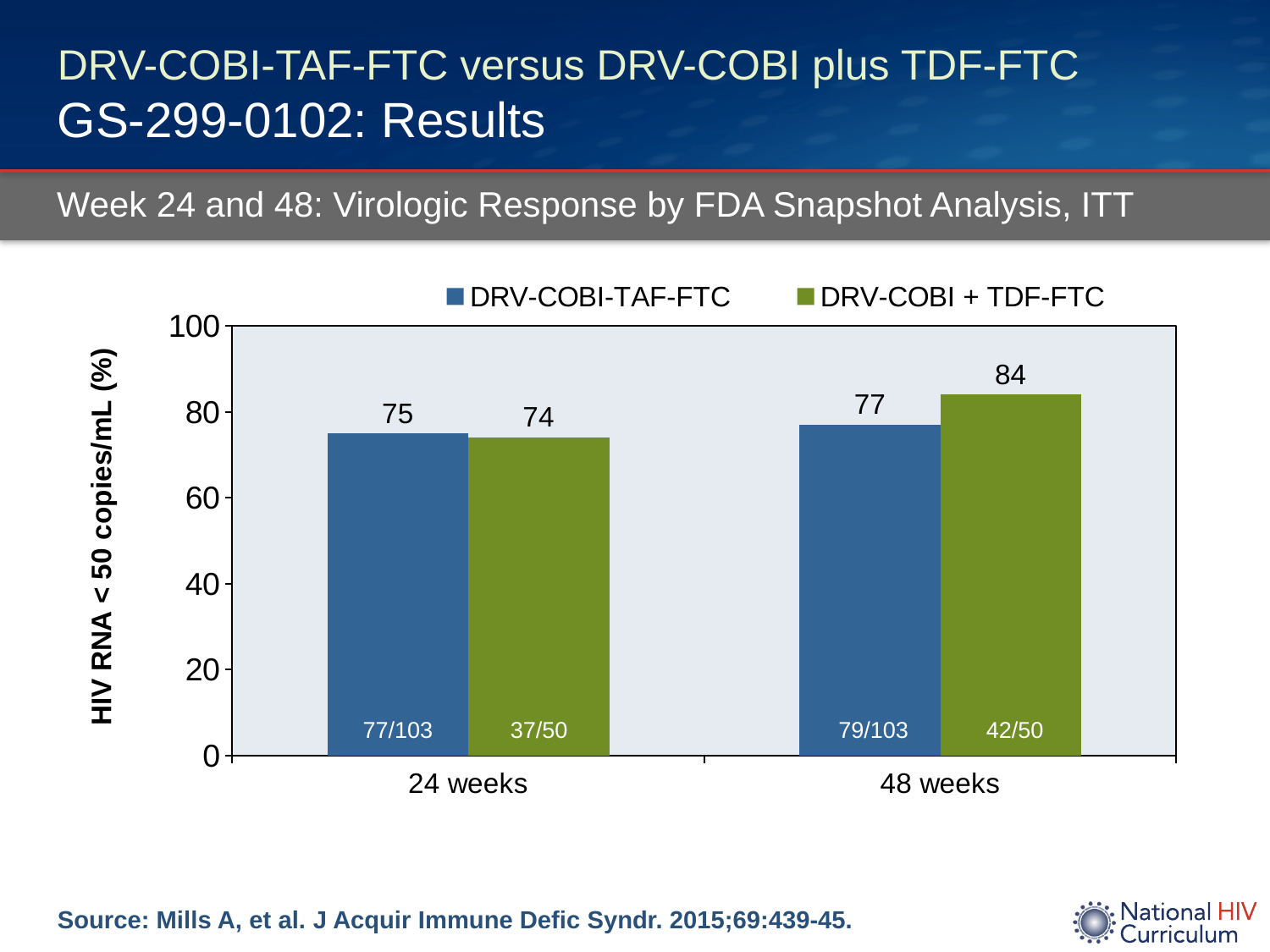
What is the value for DRV-COBI + TDF-FTC at 48 weeks? 84 What is the value for DRV-COBI + TDF-FTC at 24 weeks? 74 What is the difference between the DRV-COBI + TDF-FTC and DRV-COBI-TAF-FTC values at 48 weeks? 7 What is the value for DRV-COBI-TAF-FTC at 24 weeks? 75 Does the value for DRV-COBI + TDF-FTC rise or fall from 24 weeks to 48 weeks? Rise At 48 weeks, which series has the larger value, DRV-COBI-TAF-FTC or DRV-COBI + TDF-FTC? DRV-COBI + TDF-FTC Which bar has the highest value on the chart? DRV-COBI + TDF-FTC at 48 weeks How many series does the legend list? 2 How many categories are shown on the x axis? 2 What kind of chart is shown on the slide? Bar chart What is the y-axis label of the chart? HIV RNA < 50 copies/mL (%) What is the value for DRV-COBI-TAF-FTC at 48 weeks? 77